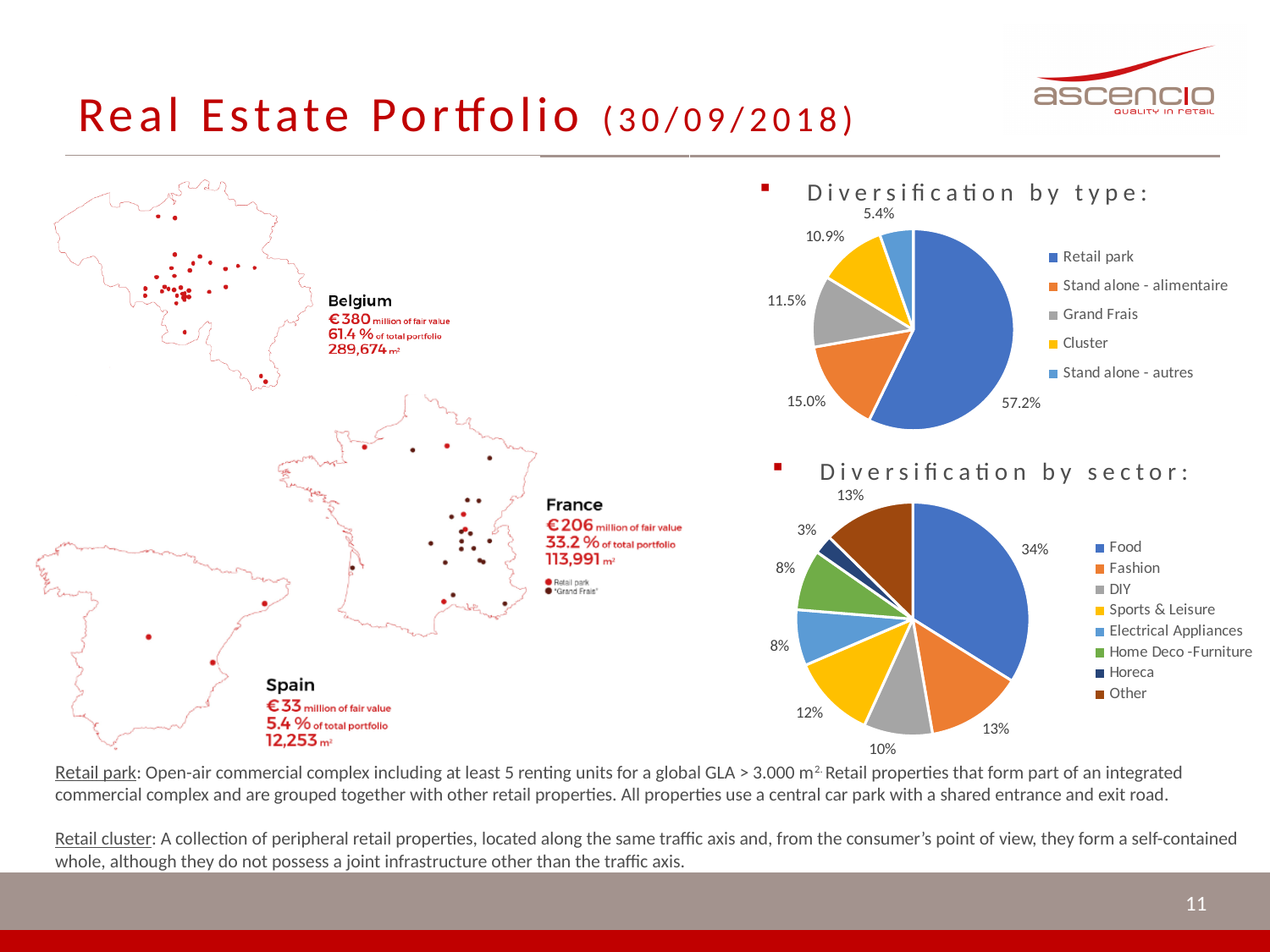
In the 'Diversification by type' pie chart, what is the difference between the shares of Stand alone - alimentaire and Cluster? 4.1% In the 'Diversification by type' pie chart, which category has the smallest share? Stand alone - autres In the 'Diversification by sector' pie chart, what share does Food have? 34% In the 'Diversification by type' pie chart, what share does Retail park have? 57.2% In the 'Diversification by type' pie chart, what colour represents Cluster? Yellow In the 'Diversification by sector' pie chart, how many sectors does the legend list? 8 What type of chart is used for 'Diversification by sector'? Pie chart In the 'Diversification by sector' pie chart, which sector has the smallest share? Horeca In the 'Diversification by type' pie chart, how many categories does the legend list? 5 In the 'Diversification by type' pie chart, what share does Grand Frais have? 11.5% In the 'Diversification by sector' pie chart, what share does Sports & Leisure have? 12% In the 'Diversification by sector' pie chart, which is larger, Fashion or DIY? Fashion